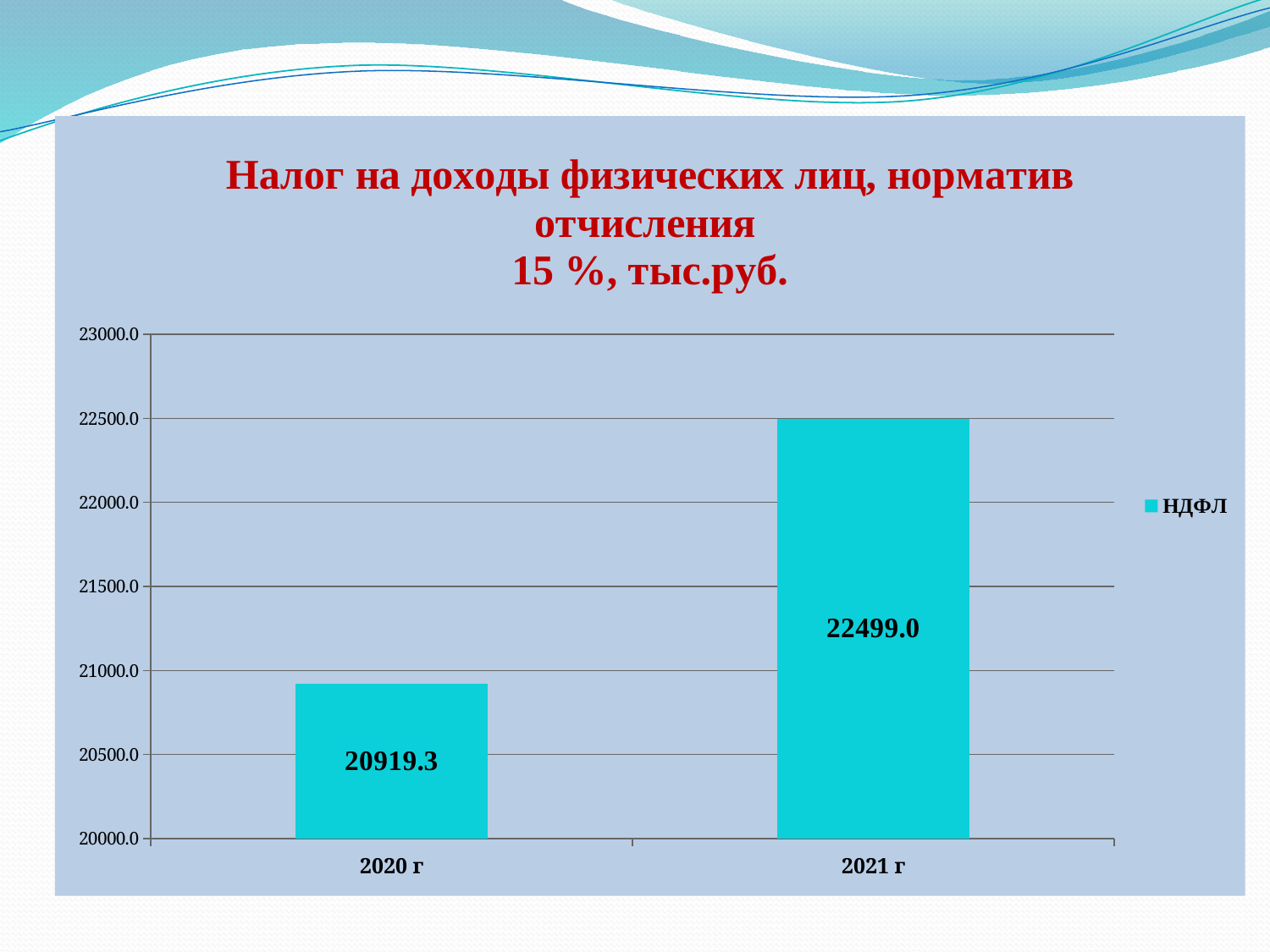
What is the name of the series in the legend? НДФЛ Is the value for 2020 г greater or less than 21000.0? less What is the value for 2020 г? 20919.3 Do the values rise or fall from 2020 г to 2021 г? rise How many series does the legend list? 1 What kind of chart is shown? bar chart Is the value for 2021 г greater or less than 22000.0? greater How many categories are shown on the x axis? 2 What is the difference between the values for 2021 г and 2020 г? 1579.7 Which year has the lower value? 2020 г Which year has the higher value? 2021 г What is the value for 2021 г? 22499.0